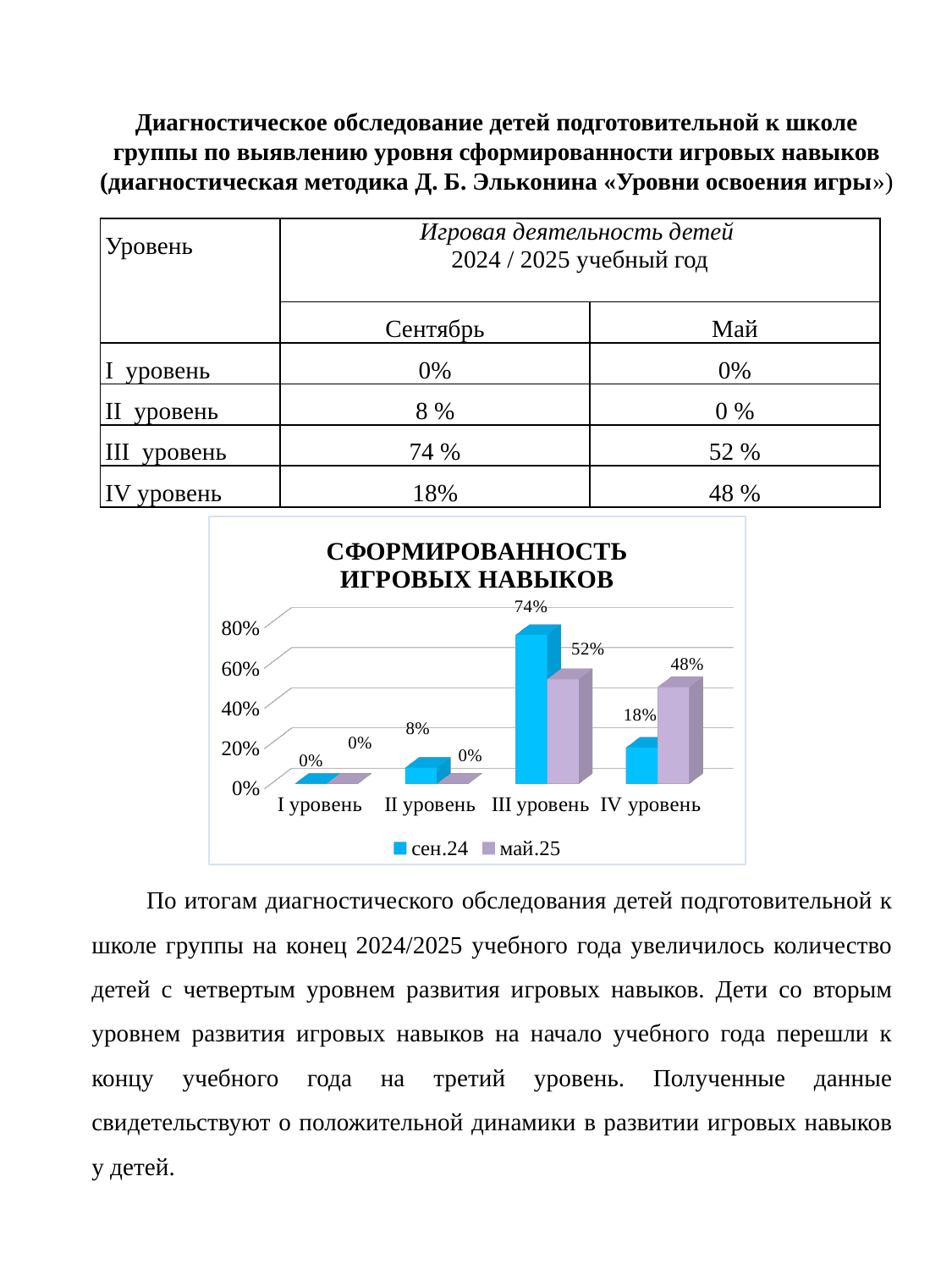
How many series does the chart legend list? 2 What type of chart is shown on the slide? bar chart Which category has the highest value in the май.25 series? III уровень Which category has the highest value in the сен.24 series? III уровень What is the difference between the май.25 and сен.24 values for IV уровень? 30% What is the value for IV уровень in the май.25 series? 48% What is the title of the chart? СФОРМИРОВАННОСТЬ ИГРОВЫХ НАВЫКОВ For IV уровень, which series has the larger value, сен.24 or май.25? май.25 What is the difference between the сен.24 and май.25 values for III уровень? 22% How many categories are shown on the x axis of the chart? 4 What is the value for II уровень in the сен.24 series? 8% What is the value for III уровень in the сен.24 series? 74%